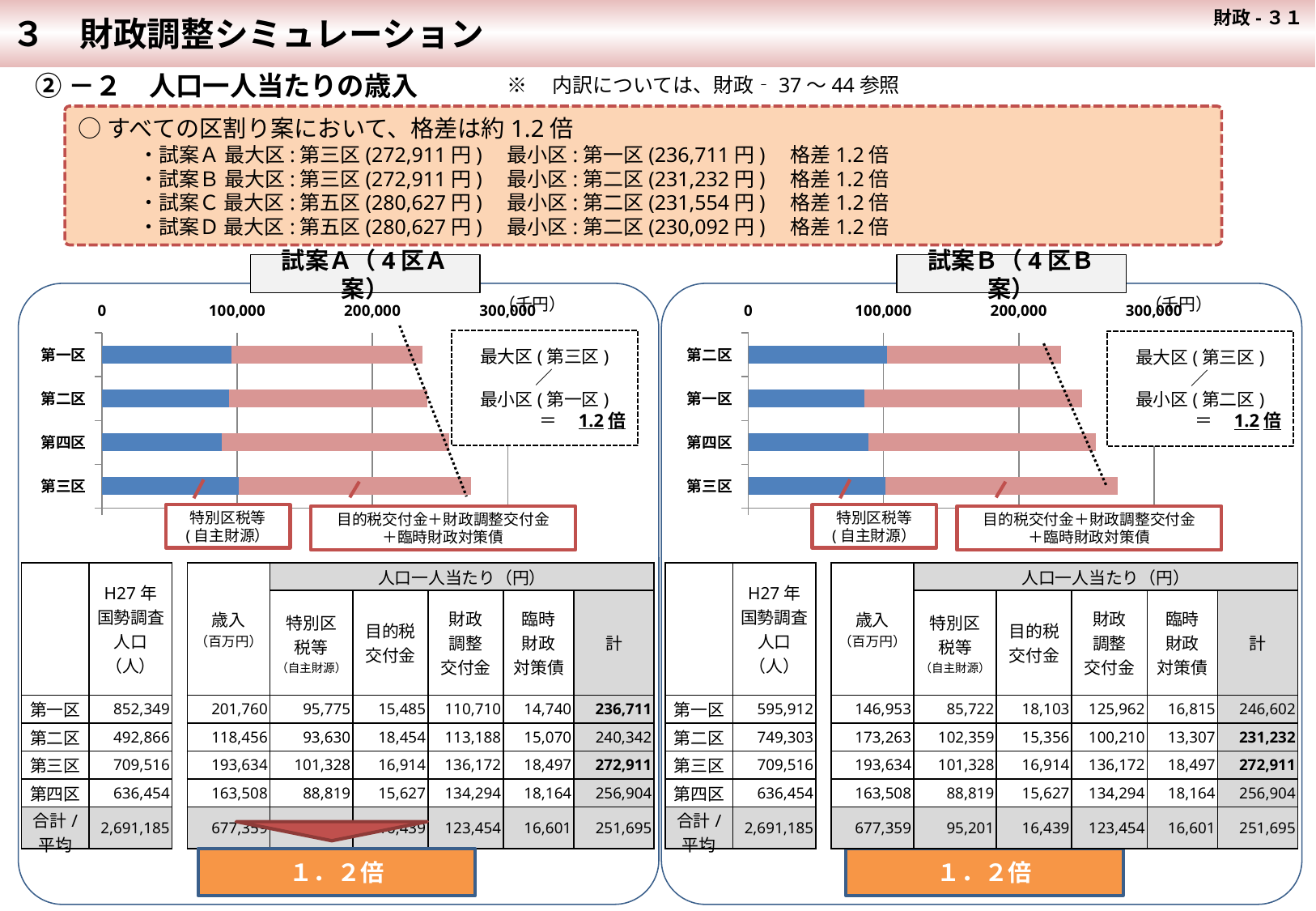
What kind of chart is the 試案A（4区A案） chart? bar chart In the 試案A（4区A案） chart, is the total value for 第一区 greater or less than 200,000? greater How many districts are plotted in the 試案A（4区A案） chart? 4 How many series does the 試案A（4区A案） chart show? 2 In the 試案A（4区A案） chart, which is larger, the total bar for 第三区 or for 第一区? 第三区 How many districts are plotted in the 試案B（4区B案） chart? 4 In the 試案A（4区A案） chart, which district has the longest total bar? 第三区 In the 試案B（4区B案） chart, which district has the shortest total bar? 第二区 In 試案A, what is the difference between the 計 for 第三区 (272,911) and the 計 for 第一区 (236,711)? 36,200 What ratio between the largest and smallest district is shown in the annotation box of the 試案B（4区B案） chart? 1.2倍 According to the table under the 試案A（4区A案） chart, what is the 計 (per-capita total) for 第三区? 272,911 In the 試案A（4区A案） chart, is the total value for 第三区 greater or less than 300,000? less